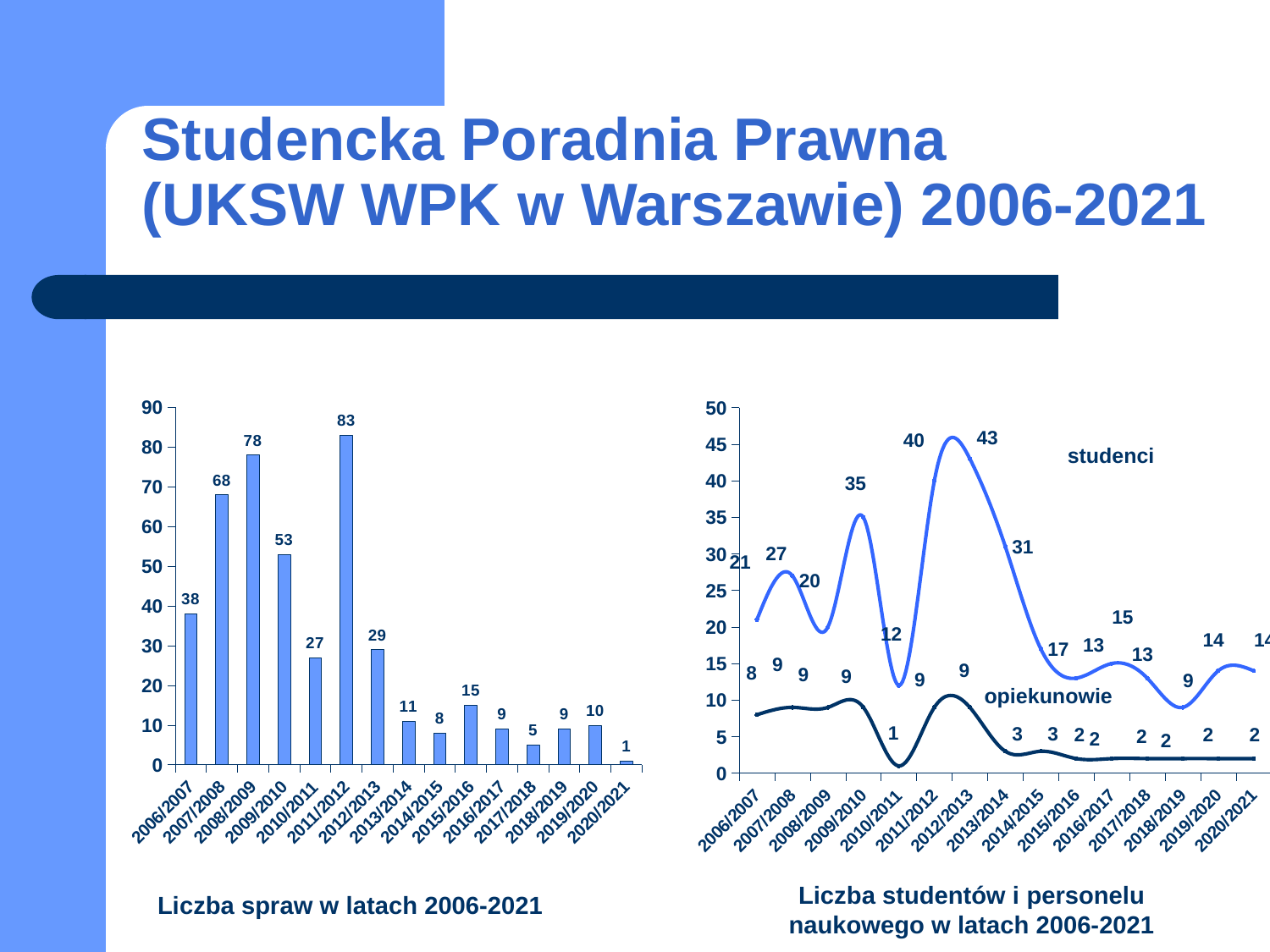
How many years are shown on the x axis of the left chart 'Liczba spraw w latach 2006-2021'? 15 What kind of chart is the left chart, 'Liczba spraw w latach 2006-2021'? bar chart What kind of chart is the right chart, 'Liczba studentów i personelu naukowego w latach 2006-2021'? line chart In the right chart 'Liczba studentów i personelu naukowego w latach 2006-2021', what is the value of 'opiekunowie' for 2010/2011? 1 In the right chart 'Liczba studentów i personelu naukowego w latach 2006-2021', what is the value of 'studenci' for 2009/2010? 35 In the left chart 'Liczba spraw w latach 2006-2021', which year has the lowest value? 2020/2021 In the left chart 'Liczba spraw w latach 2006-2021', which is larger, the value for 2009/2010 or for 2012/2013? 2009/2010 In the left chart 'Liczba spraw w latach 2006-2021', what is the value for 2011/2012? 83 How many series are plotted in the right chart 'Liczba studentów i personelu naukowego w latach 2006-2021'? 2 In the left chart 'Liczba spraw w latach 2006-2021', what is the difference between the values for 2008/2009 and 2007/2008? 10 In the right chart 'Liczba studentów i personelu naukowego w latach 2006-2021', what is the highest value of the 'studenci' series? 43 In the left chart 'Liczba spraw w latach 2006-2021', which year has the highest value? 2011/2012